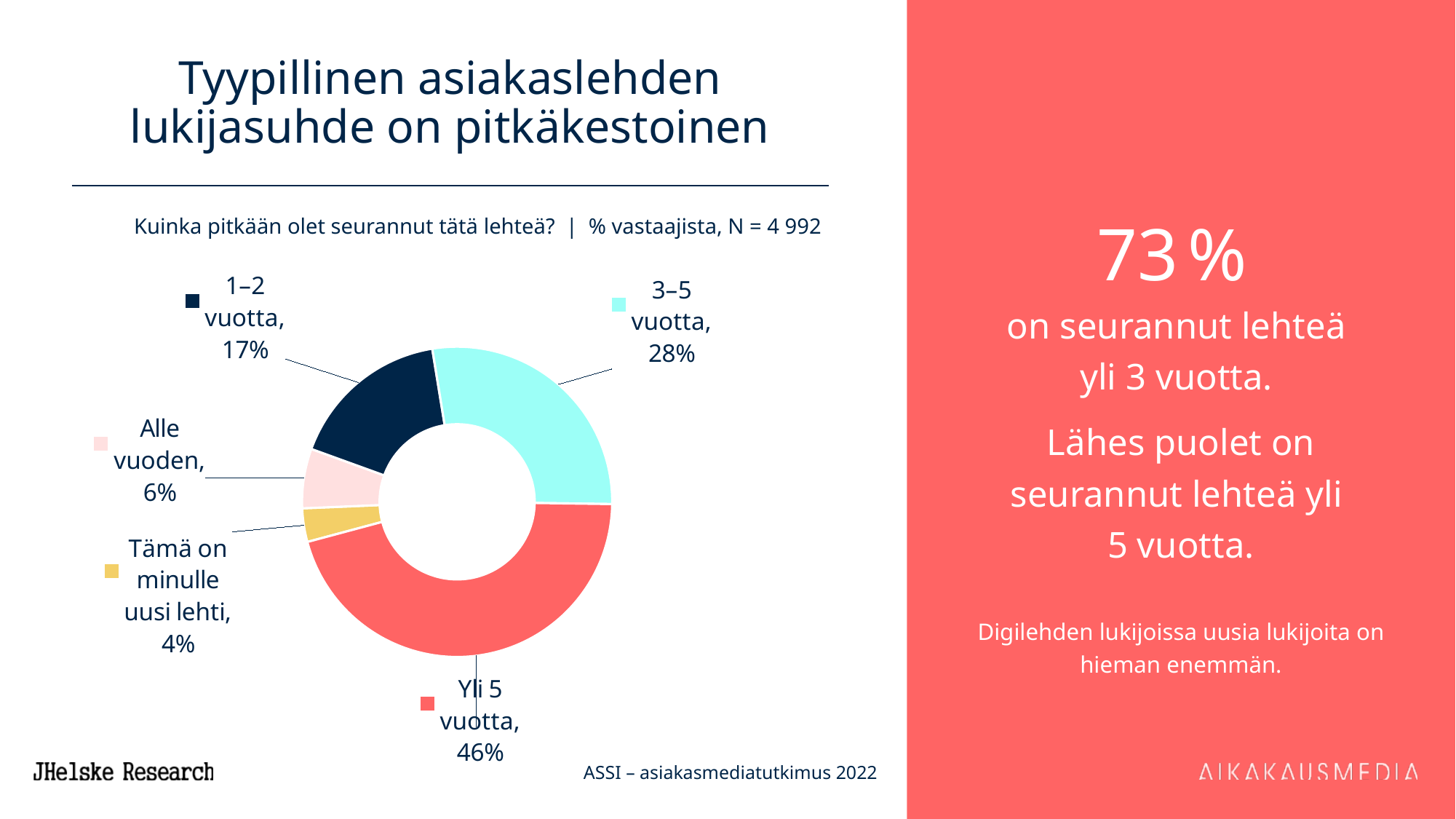
What is the difference in percentage points between 'Yli 5 vuotta' and '3–5 vuotta'? 18 What kind of chart is shown on the slide? Pie chart (doughnut) How many categories does the pie chart show? 5 What share of respondents answered 'Alle vuoden'? 6% Which category has the smallest share of the pie? Tämä on minulle uusi lehti What share of respondents answered '3–5 vuotta'? 28% Which is larger, the share for '1–2 vuotta' or the share for 'Alle vuoden'? 1–2 vuotta What share of respondents answered 'Tämä on minulle uusi lehti'? 4% What share of respondents have followed the magazine for 'Yli 5 vuotta'? 46% What share of respondents answered '1–2 vuotta'? 17% What is the number of respondents (N) stated above the chart? 4 992 Which category has the largest share of the pie? Yli 5 vuotta